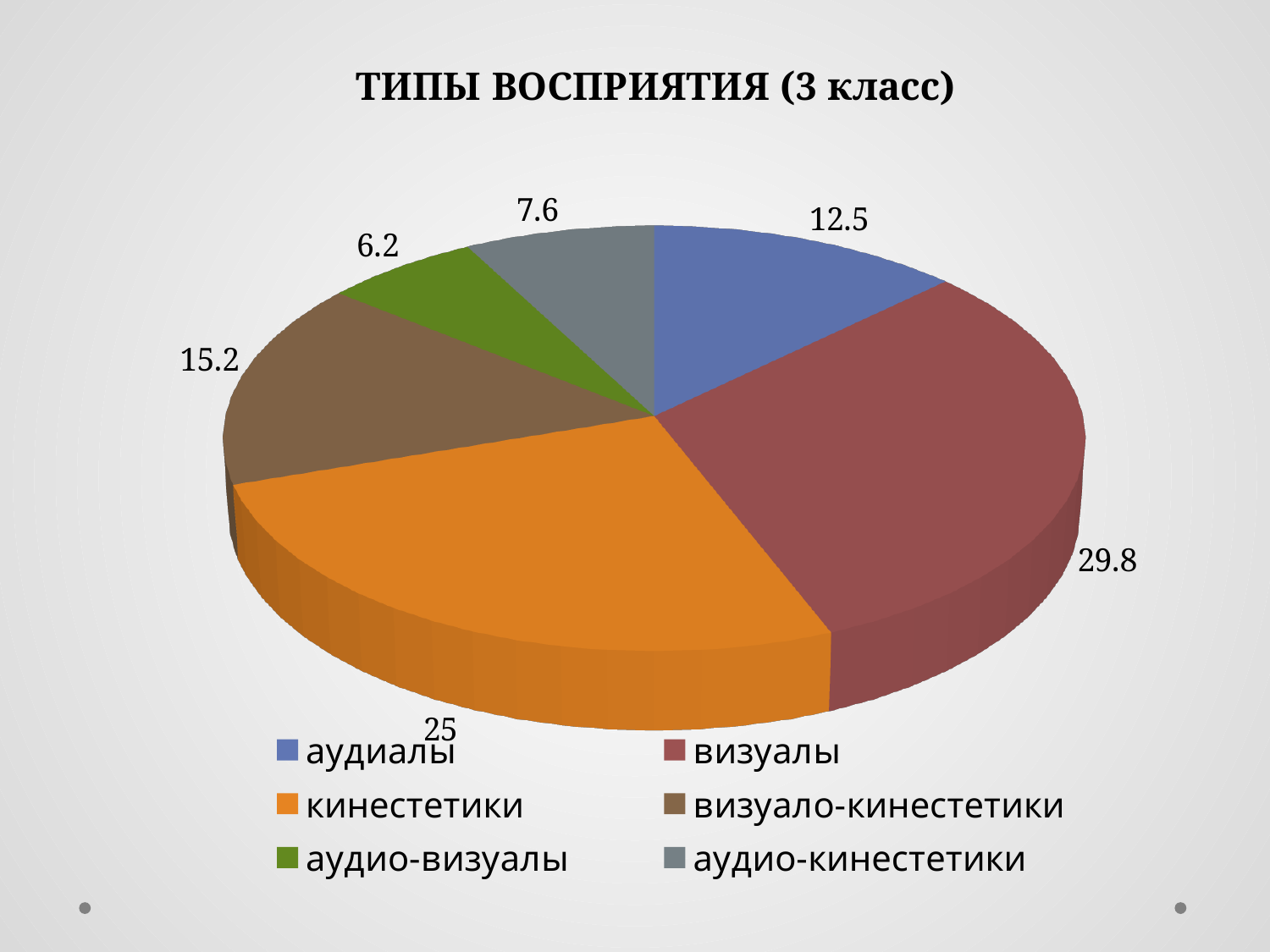
Which category has the smallest slice? аудио-визуалы Which category has the largest slice? визуалы What is the value for визуало-кинестетики? 15.2 What is the value for аудиалы? 12.5 What is the difference between the values for визуалы and кинестетики? 4.8 What is the value for визуалы? 29.8 What is the value for кинестетики? 25 What is the title of the chart? ТИПЫ ВОСПРИЯТИЯ (3 класс) How many categories are shown in the pie chart? 6 What type of chart is shown on the slide? pie chart Which is larger, the value for аудио-кинестетики or the value for аудио-визуалы? аудио-кинестетики What colour is the slice for кинестетики? orange